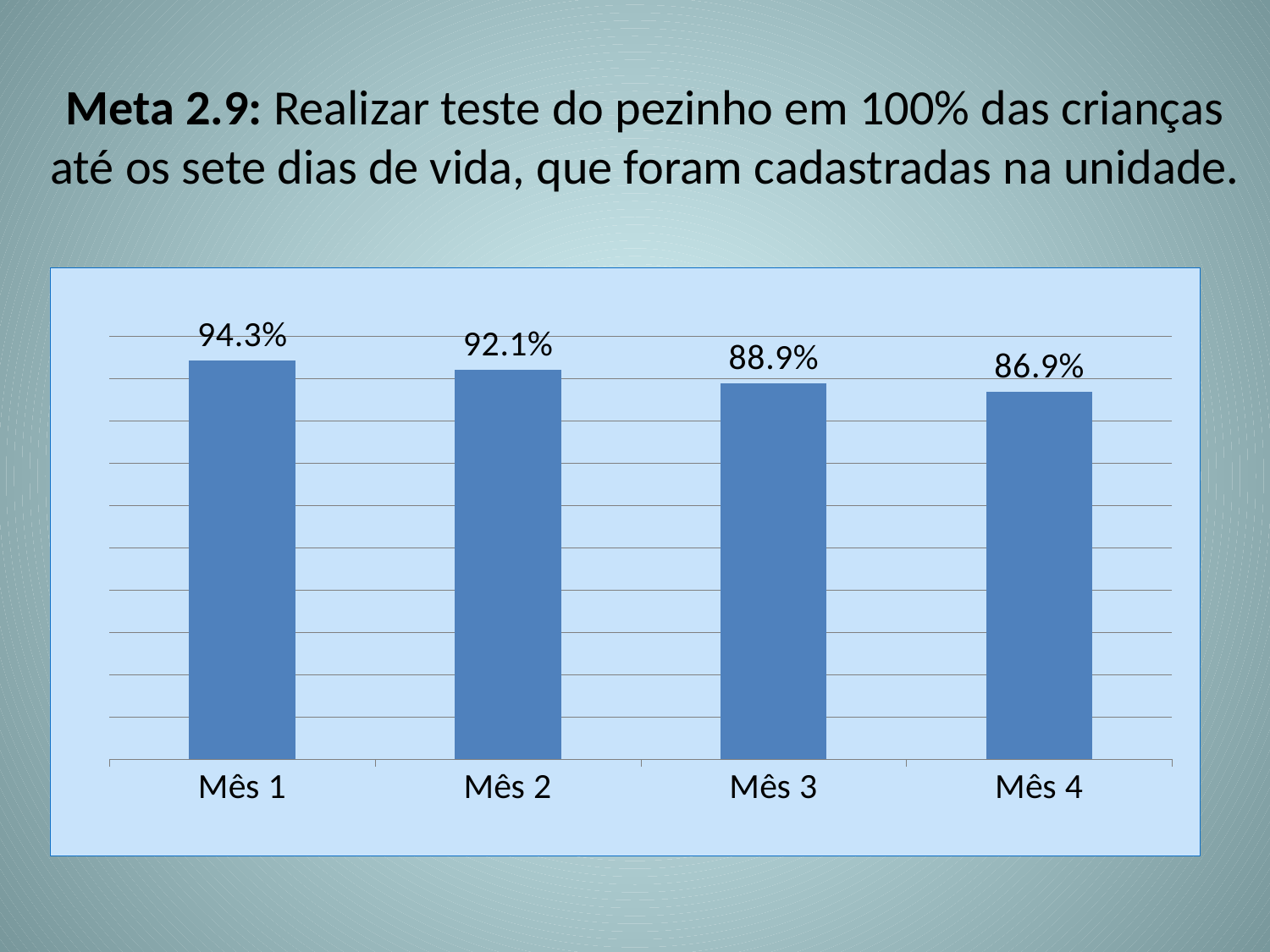
What kind of chart is shown on the slide? Bar chart Which month has the highest value? Mês 1 What is the value for Mês 4? 86.9% What is the value for Mês 3? 88.9% How many months are shown on the x axis? 4 Which is larger, the value for Mês 2 or the value for Mês 3? Mês 2 What is the difference between the values for Mês 1 and Mês 4? 7.4% What is the difference between the values for Mês 2 and Mês 3? 3.2% Which month has the lowest value? Mês 4 Do the values rise or fall from Mês 1 to Mês 4? Fall What is the value for Mês 2? 92.1% What is the value for Mês 1? 94.3%